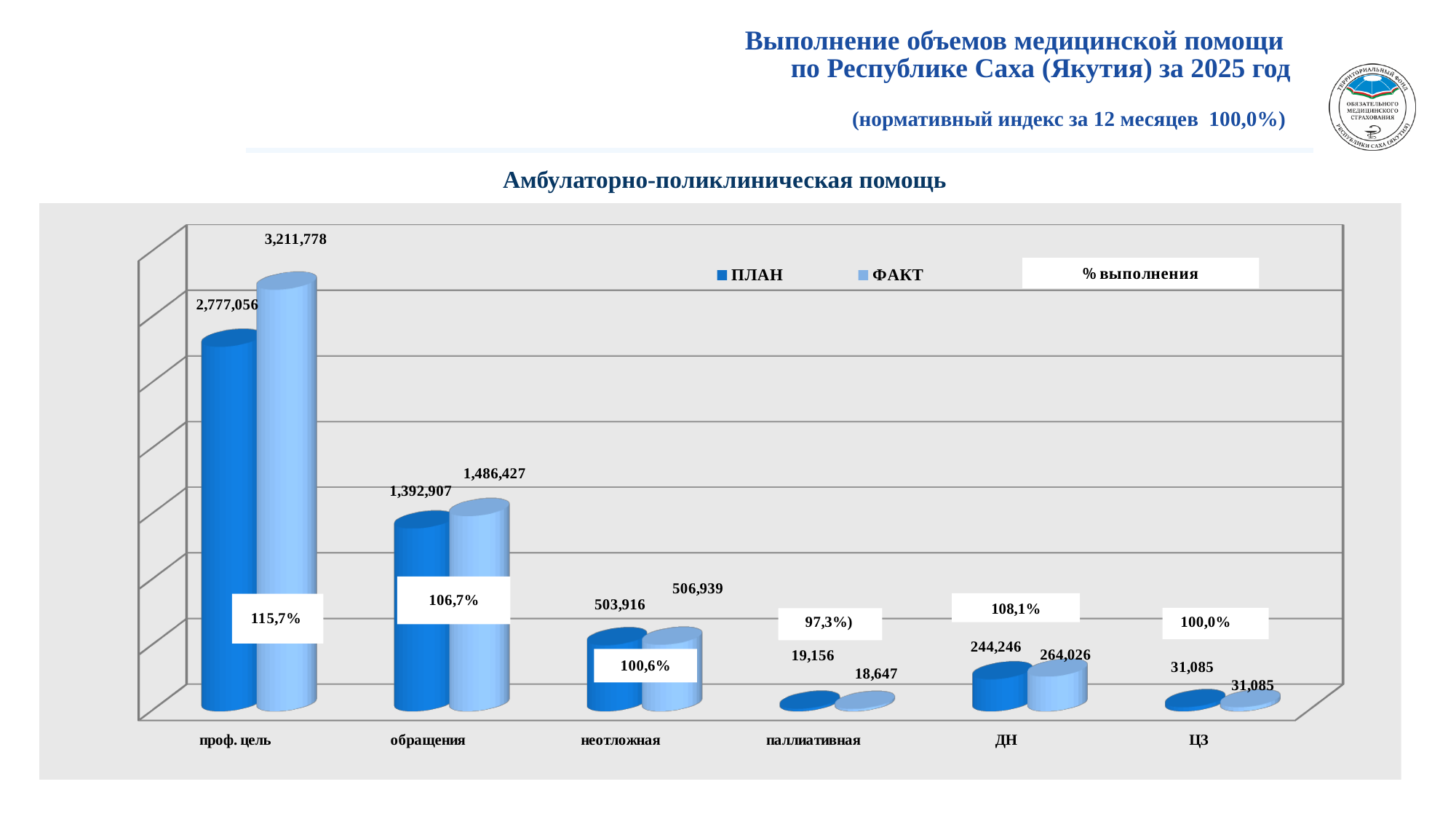
What kind of chart is shown on the slide? bar chart What is the ФАКТ value for обращения? 1,486,427 What is the ФАКТ value for ДН? 264,026 What is the difference between the ФАКТ and ПЛАН values for проф. цель? 434,722 How many series does the legend list? 2 What is the ПЛАН value for проф. цель? 2,777,056 What is the ПЛАН value for паллиативная? 19,156 Which category has the highest ФАКТ value? проф. цель What is the difference between the ФАКТ and ПЛАН values for ДН? 19,780 How many categories are shown on the x axis? 6 For паллиативная, which is larger: the ПЛАН value or the ФАКТ value? ПЛАН Which category has the lowest ПЛАН value? паллиативная